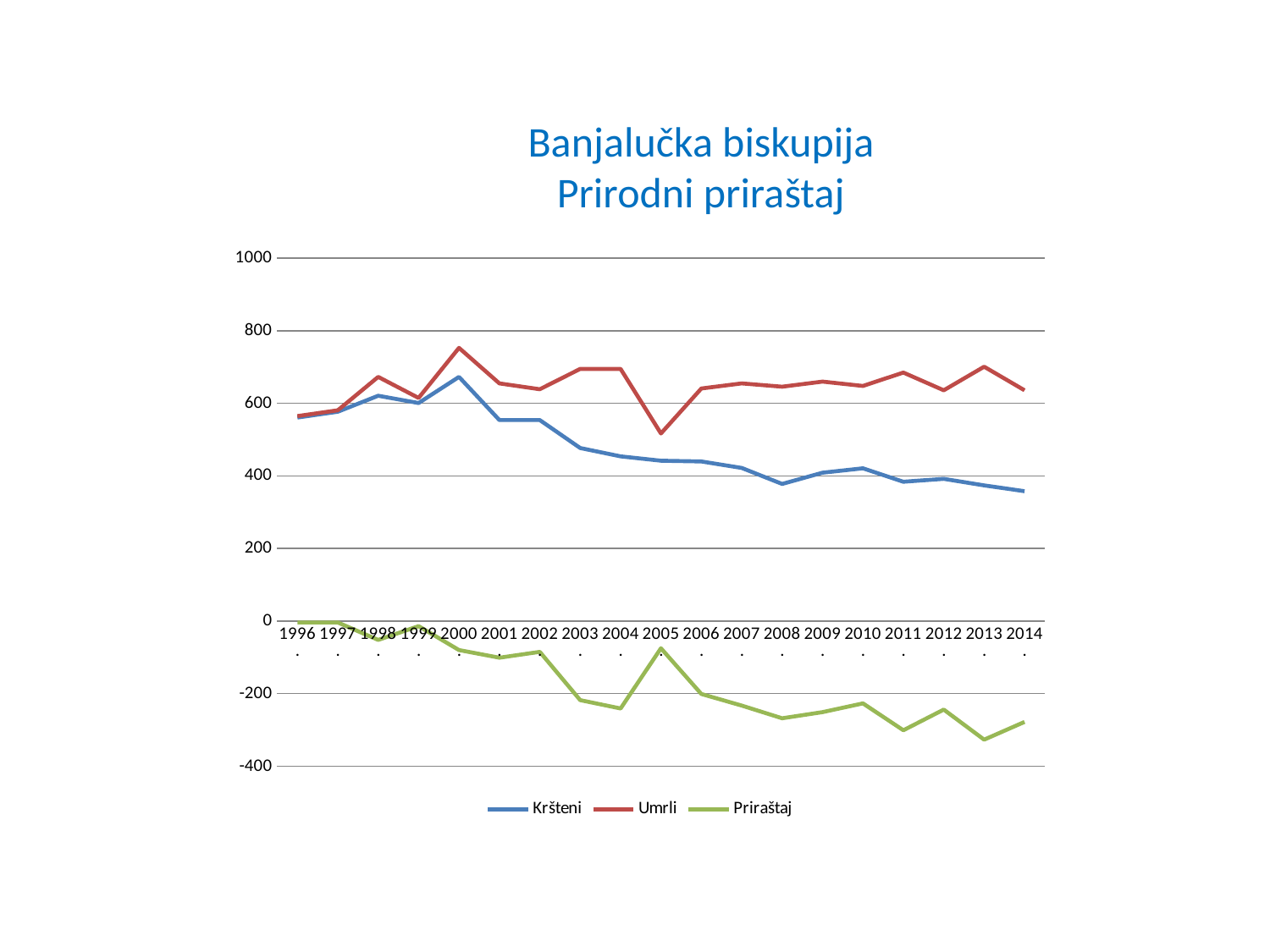
Does the Kršteni series generally rise or fall from 1996 to 2014? fall Is the value for Kršteni in 2014 greater or less than 400? less Is the value for Umrli in 2000 greater or less than 700? greater In which year does the Umrli series reach its highest value? 2000 How many series does the legend list? 3 Is the value for Priraštaj in 2004 greater or less than -200? less What colour is the Priraštaj line in the chart? green In 2005, which series has the larger value, Kršteni or Umrli? Umrli In which year does the Kršteni series reach its highest value? 2000 How many years are plotted along the x axis? 19 In which year does the Priraštaj series reach its lowest value? 2013 What kind of chart is shown on the slide? line chart